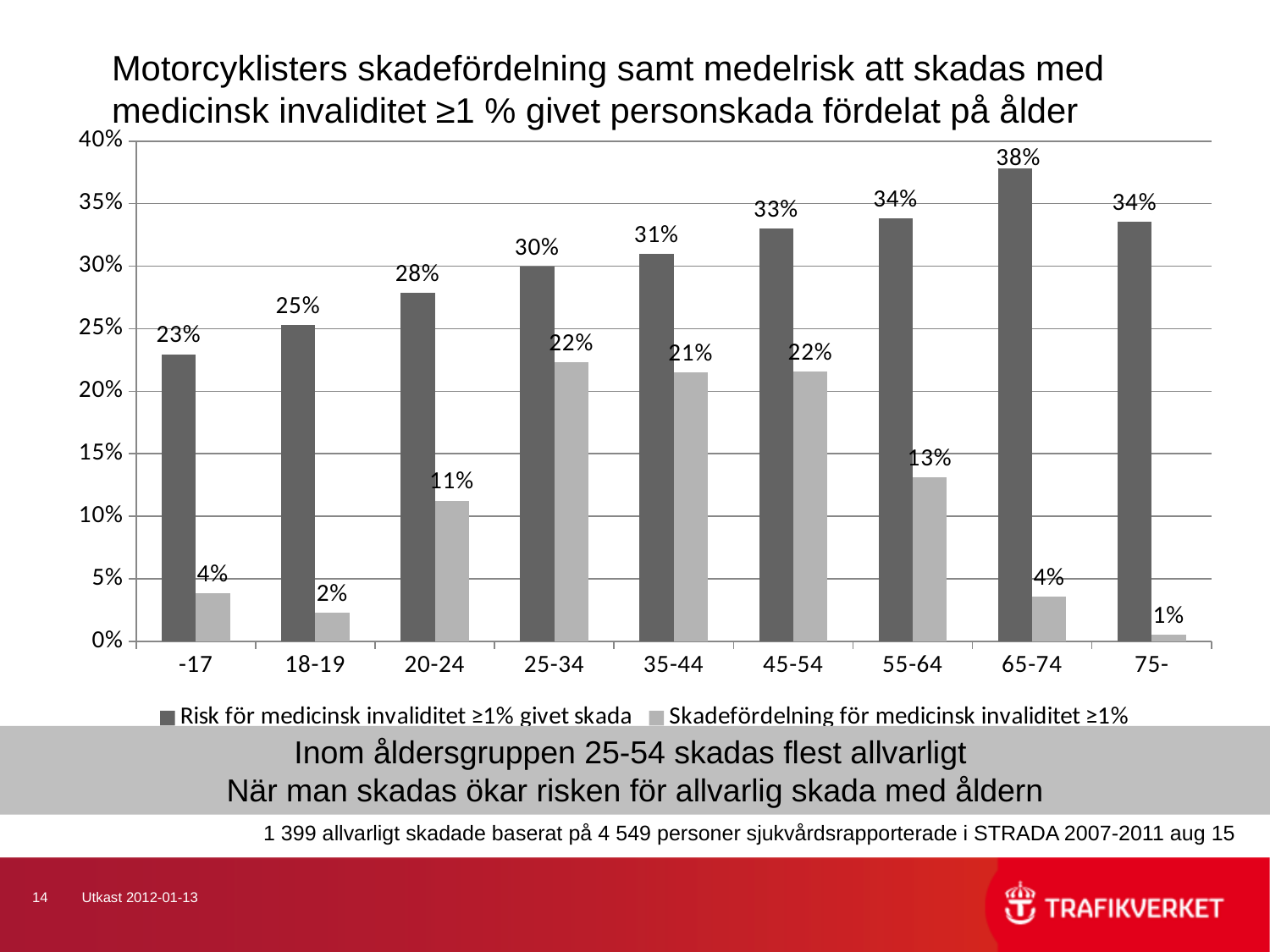
What is the value of "Risk för medicinsk invaliditet ≥1% givet skada" for the 65-74 age group? 38% What kind of chart is shown on the slide? Bar chart What is the value of "Risk för medicinsk invaliditet ≥1% givet skada" for the -17 age group? 23% Is the "Risk för medicinsk invaliditet ≥1% givet skada" value for the 45-54 age group greater or less than 30%? greater Which is larger: the "Skadefördelning för medicinsk invaliditet ≥1%" value for 55-64 or for 65-74? 55-64 Which age group has the highest value for "Risk för medicinsk invaliditet ≥1% givet skada"? 65-74 What is the difference between the "Risk för medicinsk invaliditet ≥1% givet skada" values for the 65-74 and -17 age groups? 15% How many series does the legend list? 2 What is the value of "Skadefördelning för medicinsk invaliditet ≥1%" for the 20-24 age group? 11% Which series is shown in the darker grey bars? Risk för medicinsk invaliditet ≥1% givet skada Which age group has the lowest value for "Skadefördelning för medicinsk invaliditet ≥1%"? 75- How many age groups are shown on the x axis? 9